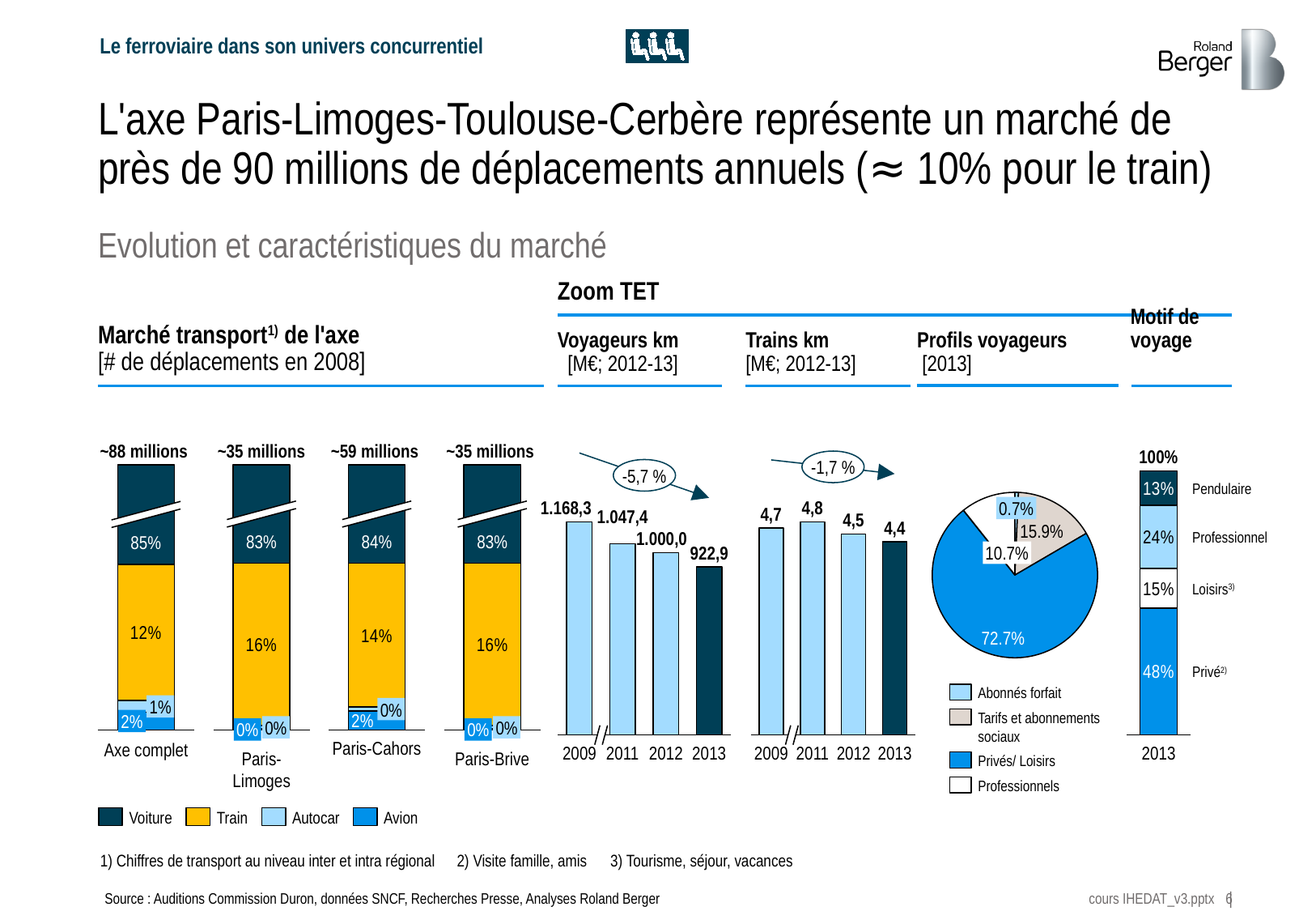
In the 'Voyageurs km' chart, which year has the highest value? 2009 In the 'Voyageurs km' chart, do the values rise or fall from 2009 to 2013? fall In the 'Trains km' chart, what is the difference between the 2011 and 2013 values? 0,4 In the 'Trains km' chart, which year has the lowest value? 2013 What kind of chart is the 'Profils voyageurs' chart? pie chart In the 'Marché transport de l'axe' chart, how many series does the legend list? 4 In the 'Marché transport de l'axe' chart, what is the Train share for Paris-Limoges? 16% In the 'Voyageurs km' chart, what is the value for 2013? 922,9 In the 'Profils voyageurs' pie chart, what share is Privés/ Loisirs? 72.7% In the 'Trains km' chart, what is the value for 2011? 4,8 In the 'Profils voyageurs' pie chart, which category has the smallest slice? Abonnés forfait In the 'Motif de voyage' chart, what is the share for Privé? 48%